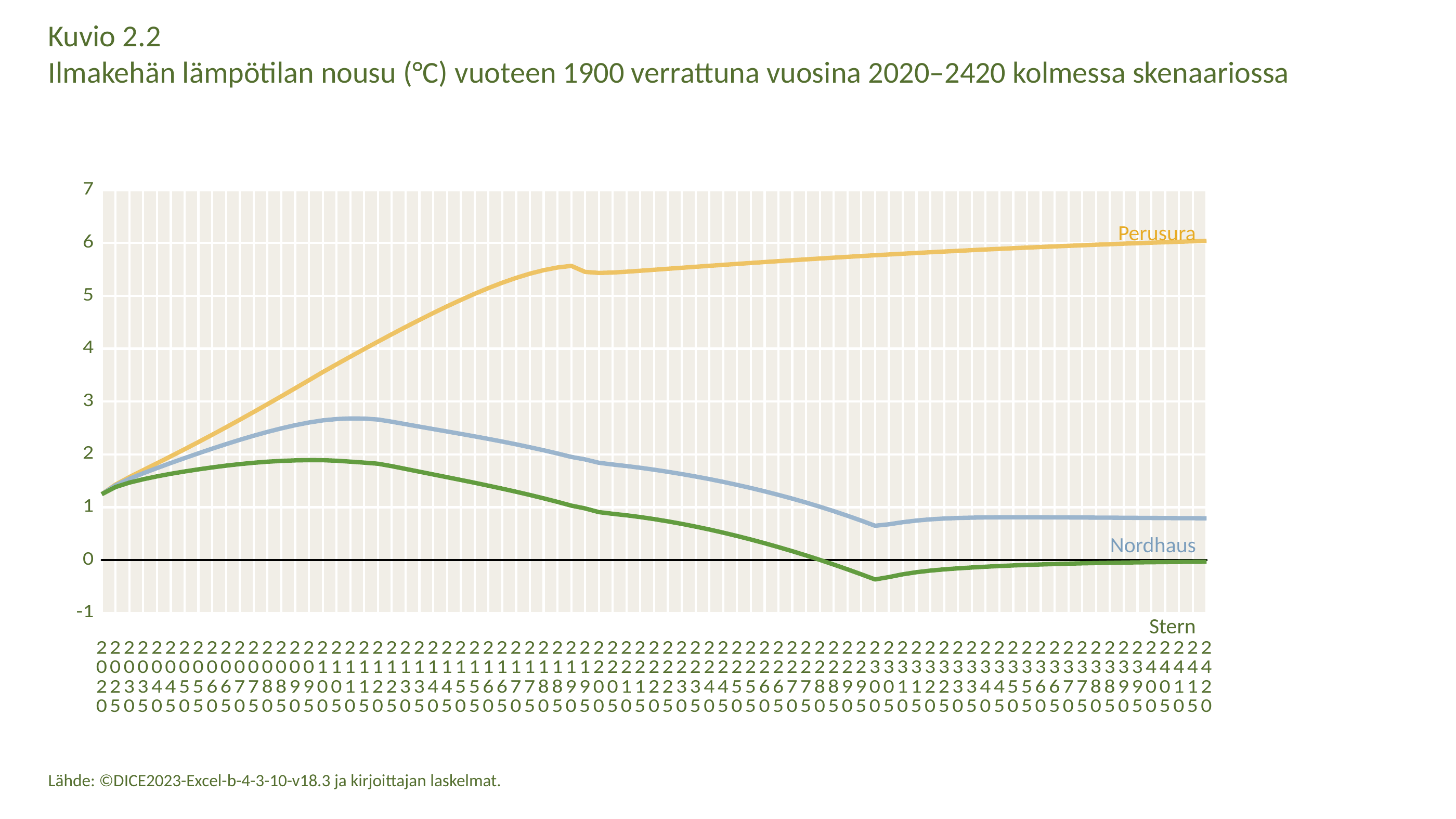
What is the figure number given above the chart title? Kuvio 2.2 What kind of chart is shown on the slide? line chart Is the value for Stern in 2420 greater or less than 1? less How many series are labelled on the chart? 3 Does the Perusura series rise or fall from 2020 to 2420? rise Is the value for Stern in 2300 greater or less than 0? less Is the value for Nordhaus in 2100 greater or less than 2? greater Which is larger in 2420, the value for Nordhaus or the value for Stern? Nordhaus Which series has the lowest value in 2420? Stern Which series has the highest value in 2420? Perusura